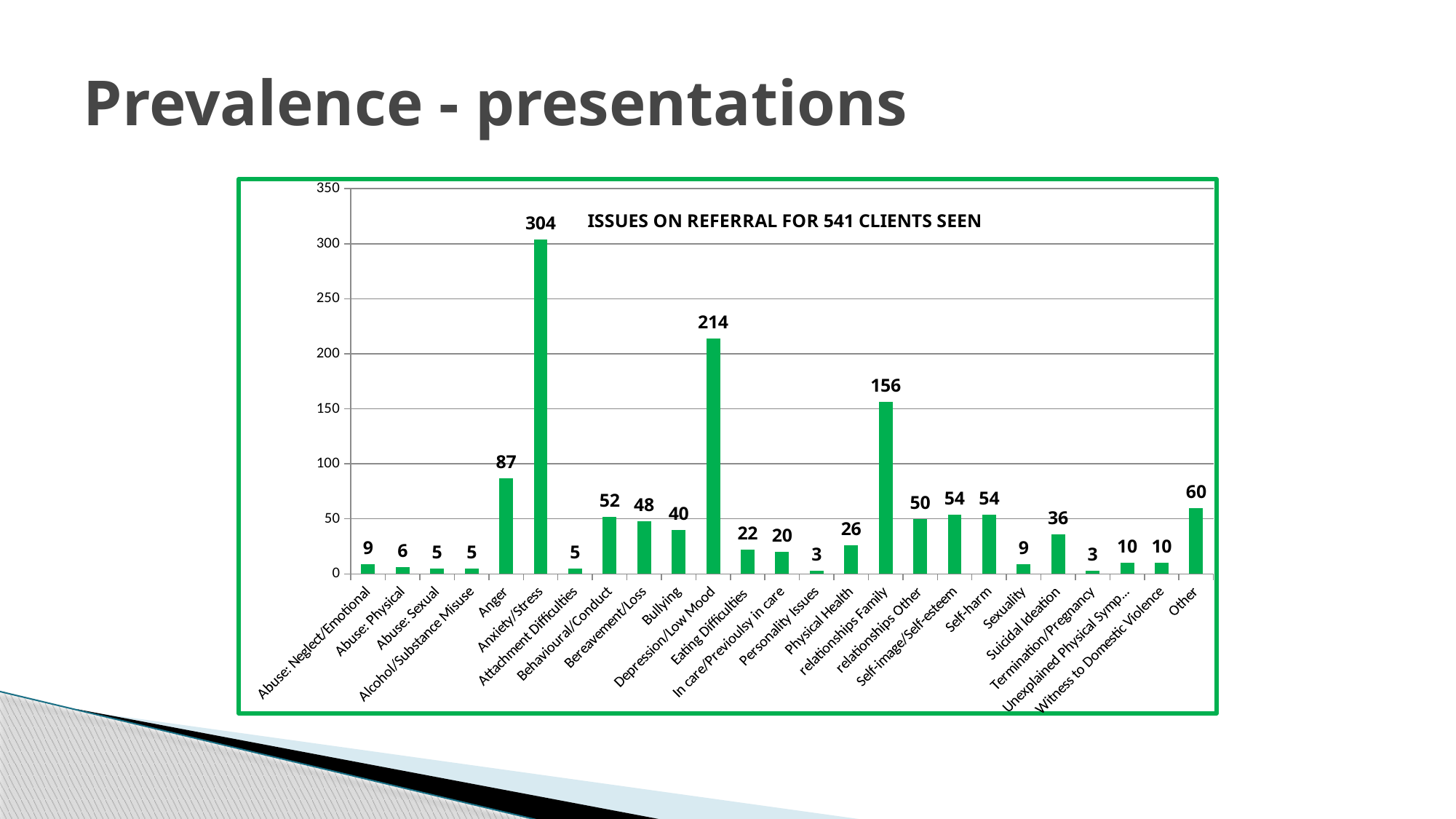
What is the difference between the values for Anger and Other? 27 How many categories are shown on the x axis? 25 Which is larger, the value for Bereavement/Loss or the value for Bullying? Bereavement/Loss What is the title printed inside the chart? ISSUES ON REFERRAL FOR 541 CLIENTS SEEN What is the value for Depression/Low Mood? 214 Is the value for relationships Family greater or less than 150? greater What is the value for Suicidal Ideation? 36 Which category has the highest value? Anxiety/Stress What is the value for relationships Family? 156 What kind of chart is shown on the slide? Bar chart What is the value for Anxiety/Stress? 304 What is the difference between the values for Anxiety/Stress and Depression/Low Mood? 90